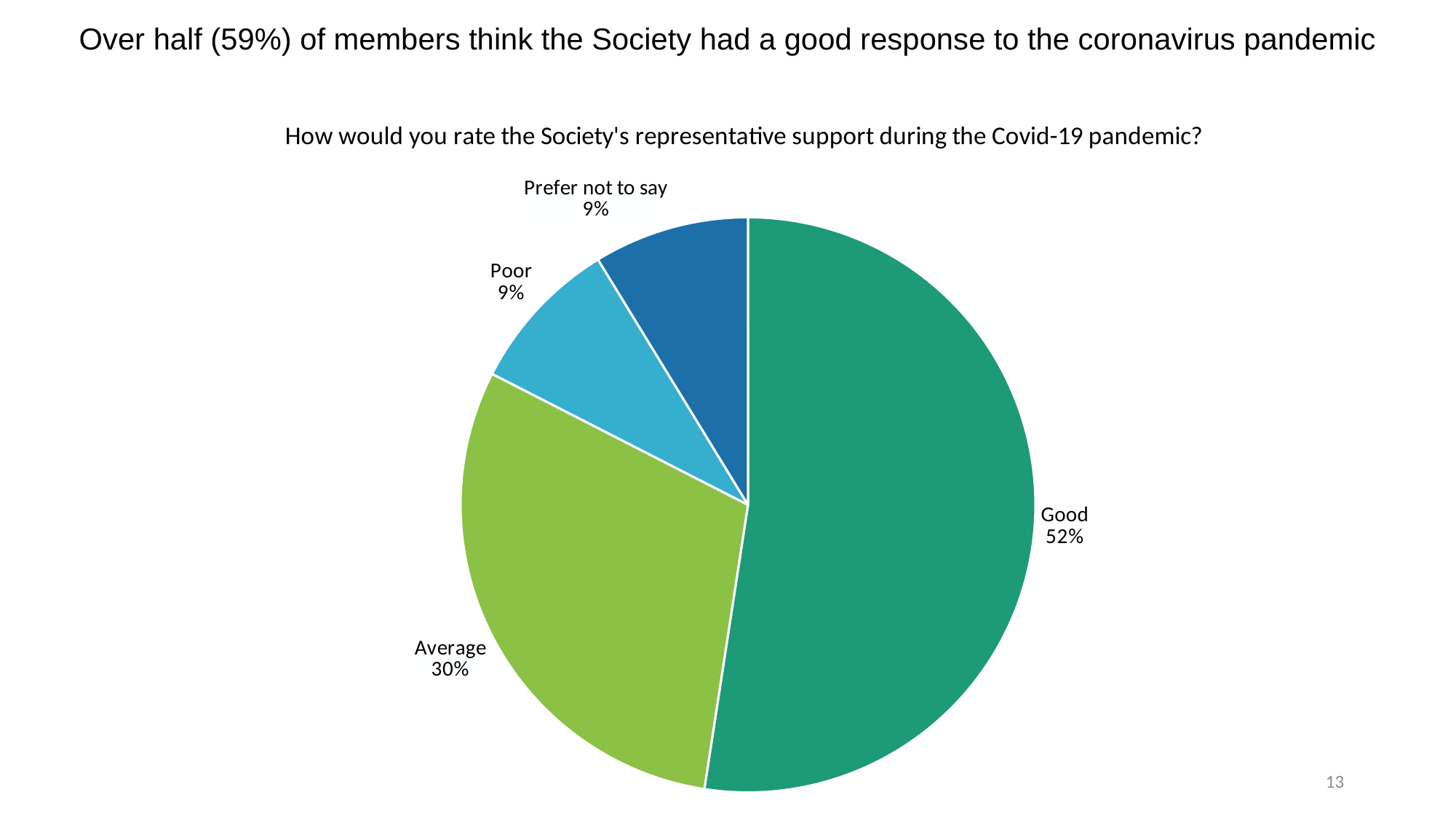
Which category has the largest slice of the pie? Good What percentage of respondents rated the support as Poor? 9% Which is larger, the Good slice or the Average slice? Good What percentage of respondents rated the support as Average? 30% What type of chart is shown on the slide? Pie chart What is the difference in percentage points between the Good and Average slices? 22 What percentage of respondents chose Prefer not to say? 9% Which is larger, the Average slice or the Poor slice? Average What is the difference in percentage points between the Average and Poor slices? 21 What share of the pie does the Good slice represent? 52% What is the title of the chart? How would you rate the Society's representative support during the Covid-19 pandemic? How many categories are shown in the pie chart? 4